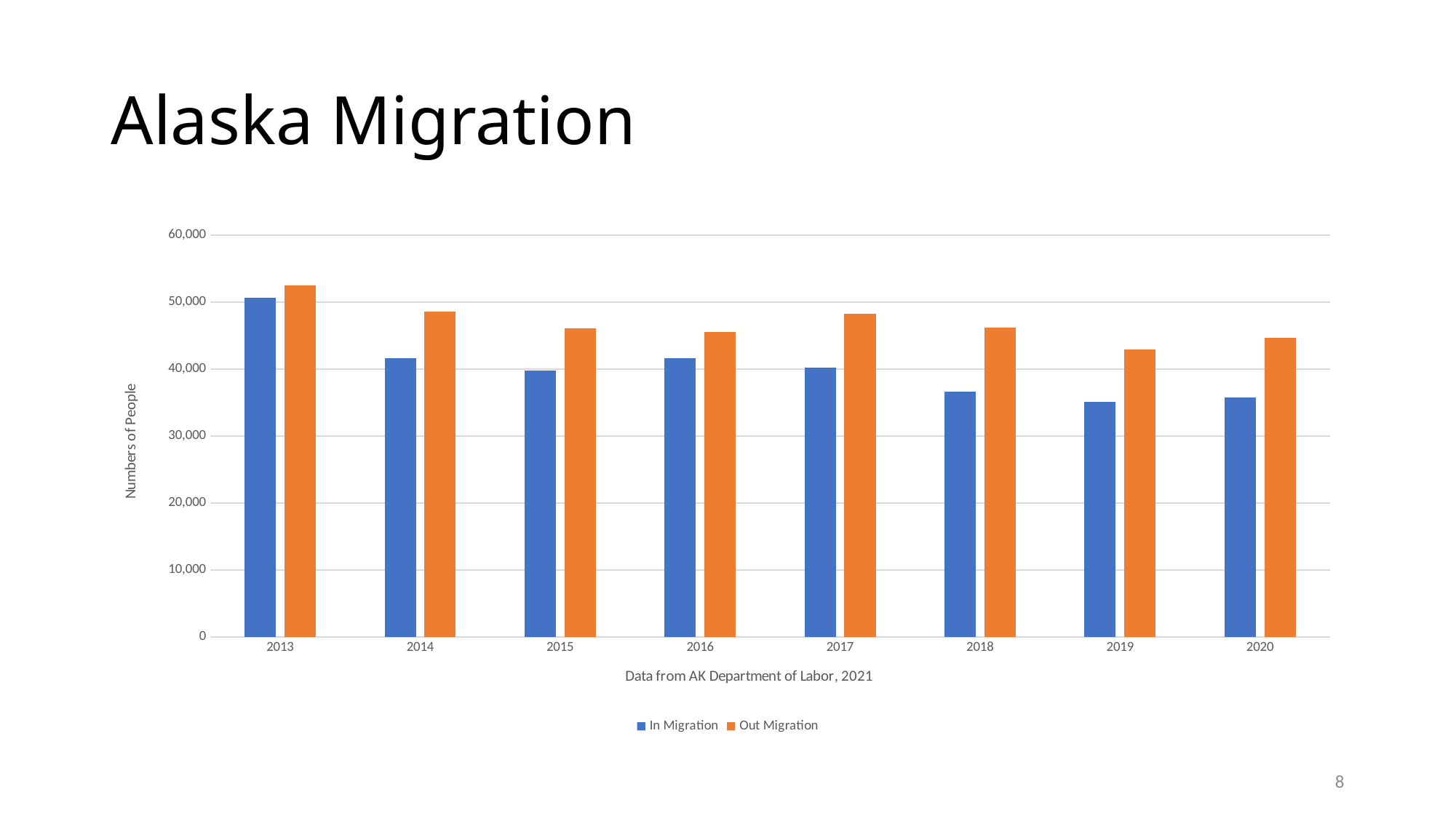
Which year has the highest In Migration value? 2013 What is the label on the vertical axis? Numbers of People How many series does the legend list? 2 In 2013, which is larger, In Migration or Out Migration? Out Migration Is the In Migration value for 2018 greater or less than 40,000? less Does In Migration generally rise or fall from 2013 to 2020? fall Is the Out Migration value for 2014 greater or less than 50,000? less Which is larger, Out Migration in 2017 or Out Migration in 2018? 2017 Which year has the highest Out Migration value? 2013 Which year has the lowest Out Migration value? 2019 How many years are shown on the x axis? 8 What kind of chart is shown on the slide? Bar chart